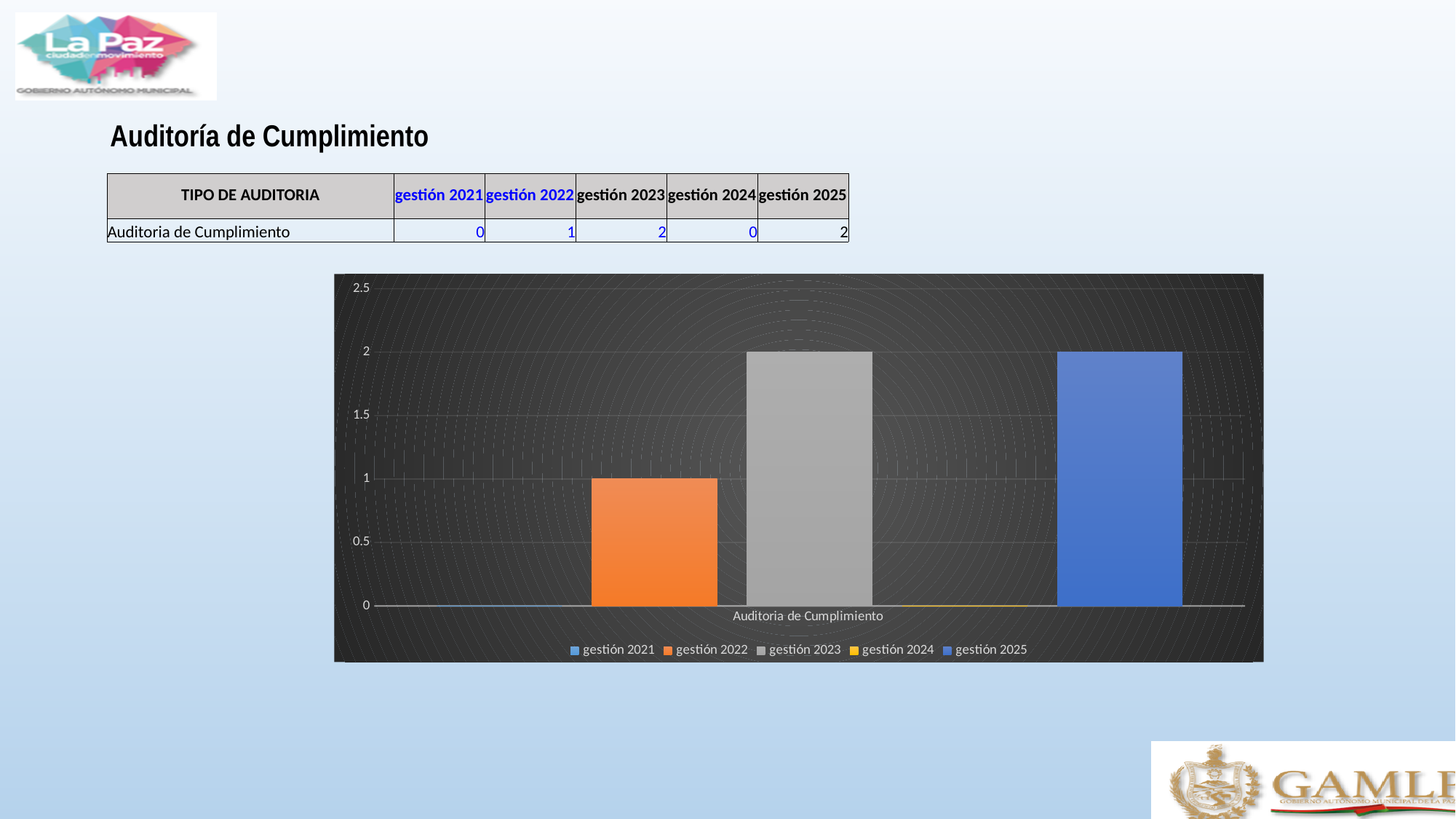
What is the value for gestión 2025 in the chart? 2 Which is larger, the value for gestión 2022 or gestión 2023? gestión 2023 What is the category label shown on the x axis of the chart? Auditoria de Cumplimiento What is the value for gestión 2023 in the chart? 2 Is the value for gestión 2022 greater or less than 1.5? less What is the difference between the values for gestión 2023 and gestión 2022? 1 What is the value for gestión 2022 in the chart? 1 Which is larger, the value for gestión 2024 or gestión 2025? gestión 2025 How many series does the legend list? 5 What is the value for gestión 2024 in the chart? 0 What kind of chart is shown on the slide? bar chart What is the value for gestión 2021 in the chart? 0